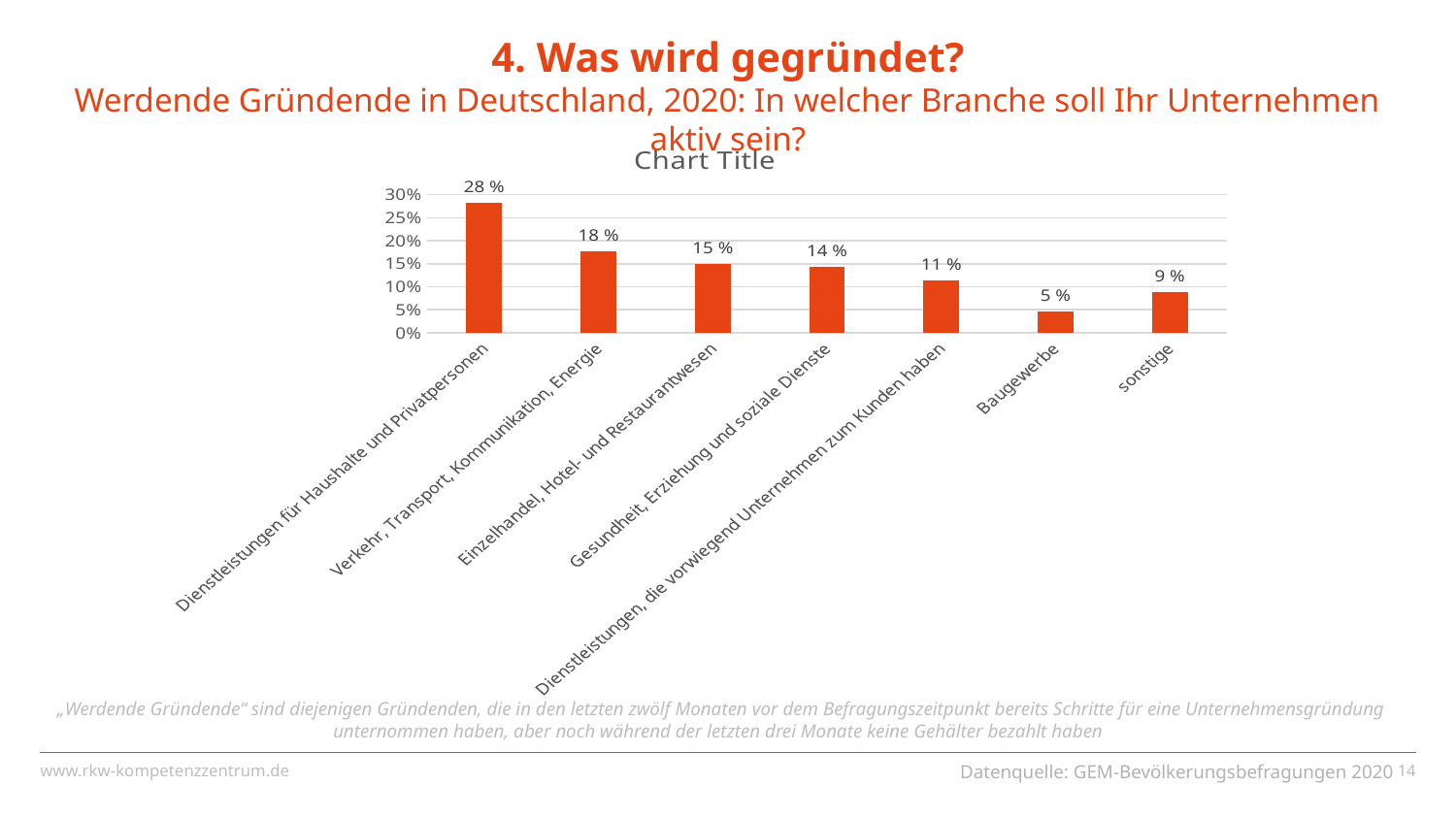
What is the title printed directly above the chart? Chart Title How many categories are shown in the chart? 7 What is the difference between Dienstleistungen für Haushalte und Privatpersonen and Gesundheit, Erziehung und soziale Dienste? 14 % What is the value for sonstige? 9 % Which is larger: Dienstleistungen, die vorwiegend Unternehmen zum Kunden haben or sonstige? Dienstleistungen, die vorwiegend Unternehmen zum Kunden haben Is the value for Gesundheit, Erziehung und soziale Dienste greater or less than 10%? greater What is the value for Einzelhandel, Hotel- und Restaurantwesen? 15 % What kind of chart is shown on the slide? bar chart What is the value for Verkehr, Transport, Kommunikation, Energie? 18 % Which category has the highest value? Dienstleistungen für Haushalte und Privatpersonen Which category has the lowest value? Baugewerbe What is the value for Baugewerbe? 5 %